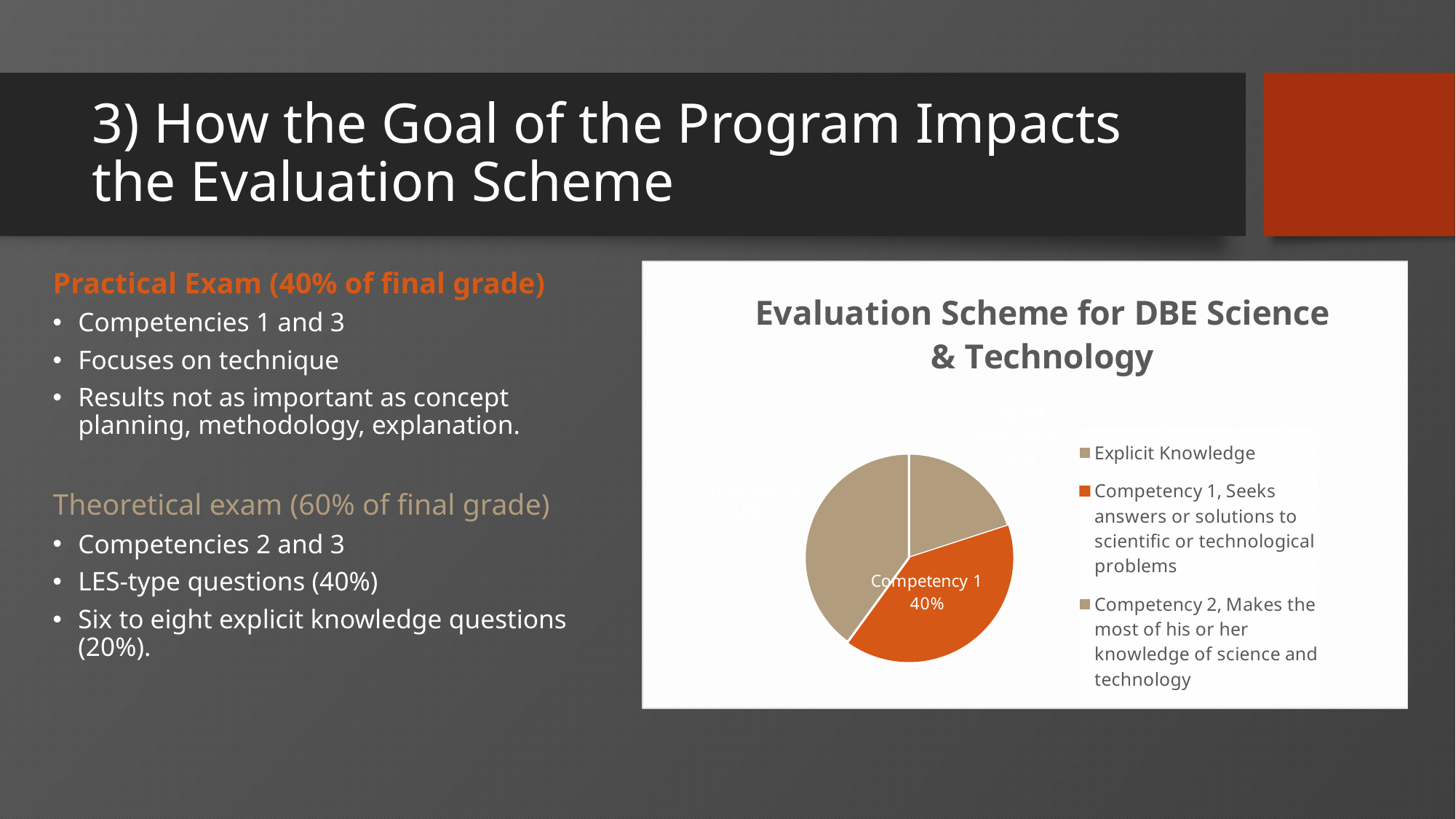
How many entries does the chart legend list? 3 What colour is the Competency 1 slice in the pie chart? orange What percentage is shown for the Competency 1 slice? 40% Which slice of the pie chart is the smallest? Explicit Knowledge Which is larger, the Competency 2 slice or the Explicit Knowledge slice? Competency 2 What kind of chart is shown on the slide? pie chart Which is larger, the Competency 1 slice or the Explicit Knowledge slice? Competency 1 What is the title of the chart? Evaluation Scheme for DBE Science & Technology How many slices does the pie chart have? 3 What share of the pie does Competency 1 represent? 40%